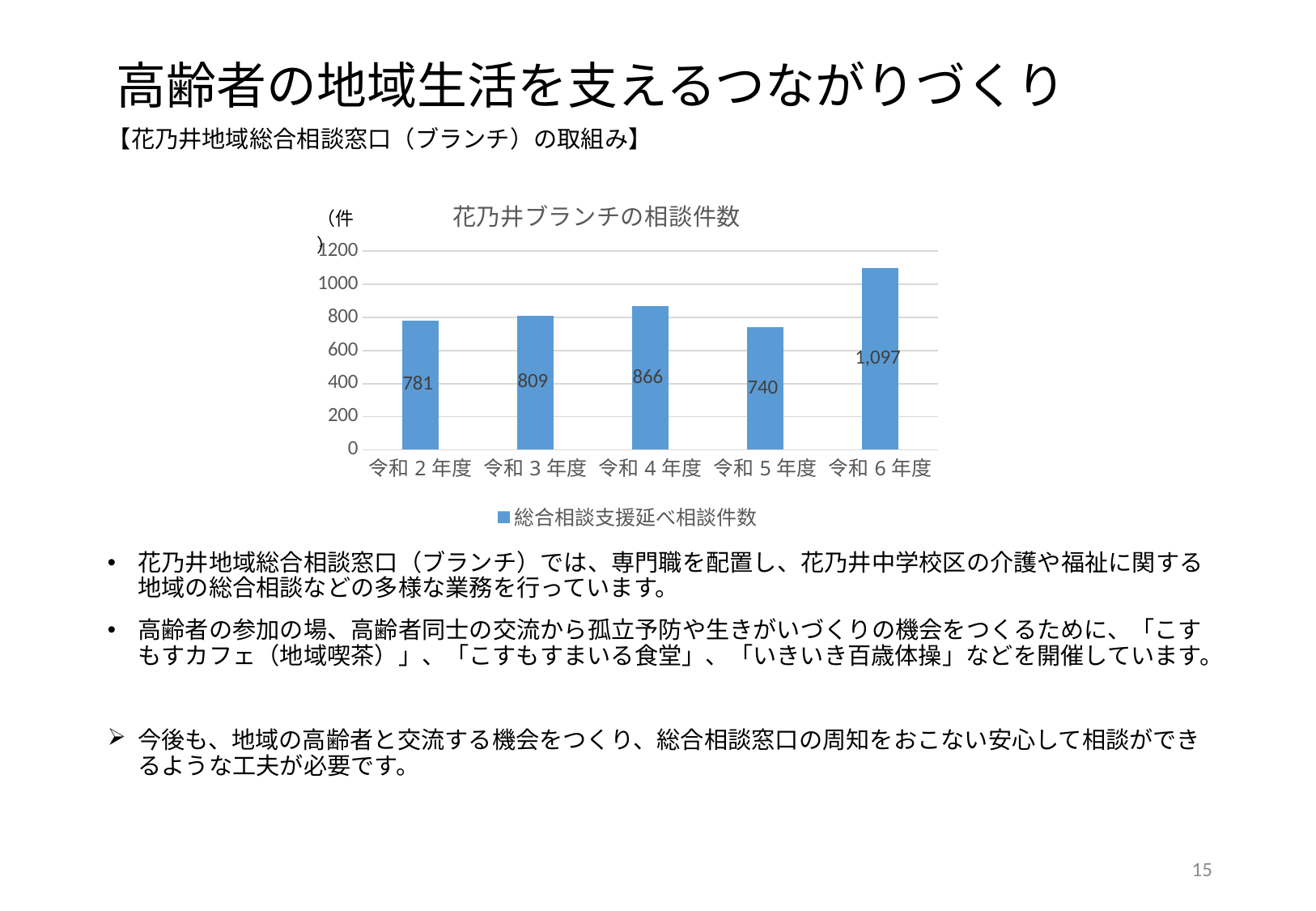
What is the value for 令和６年度? 1,097 What is the difference between the values for 令和６年度 and 令和５年度? 357 Which year has the lowest value? 令和５年度 How many series does the legend list? 1 What kind of chart is shown? bar chart Is the value for 令和６年度 greater or less than 1000? greater Which year has the highest value? 令和６年度 How many years are shown on the x axis? 5 Which is larger, the value for 令和３年度 or 令和４年度? 令和４年度 What is the value for 令和２年度? 781 What is the value for 令和５年度? 740 What is the title of the chart? 花乃井ブランチの相談件数